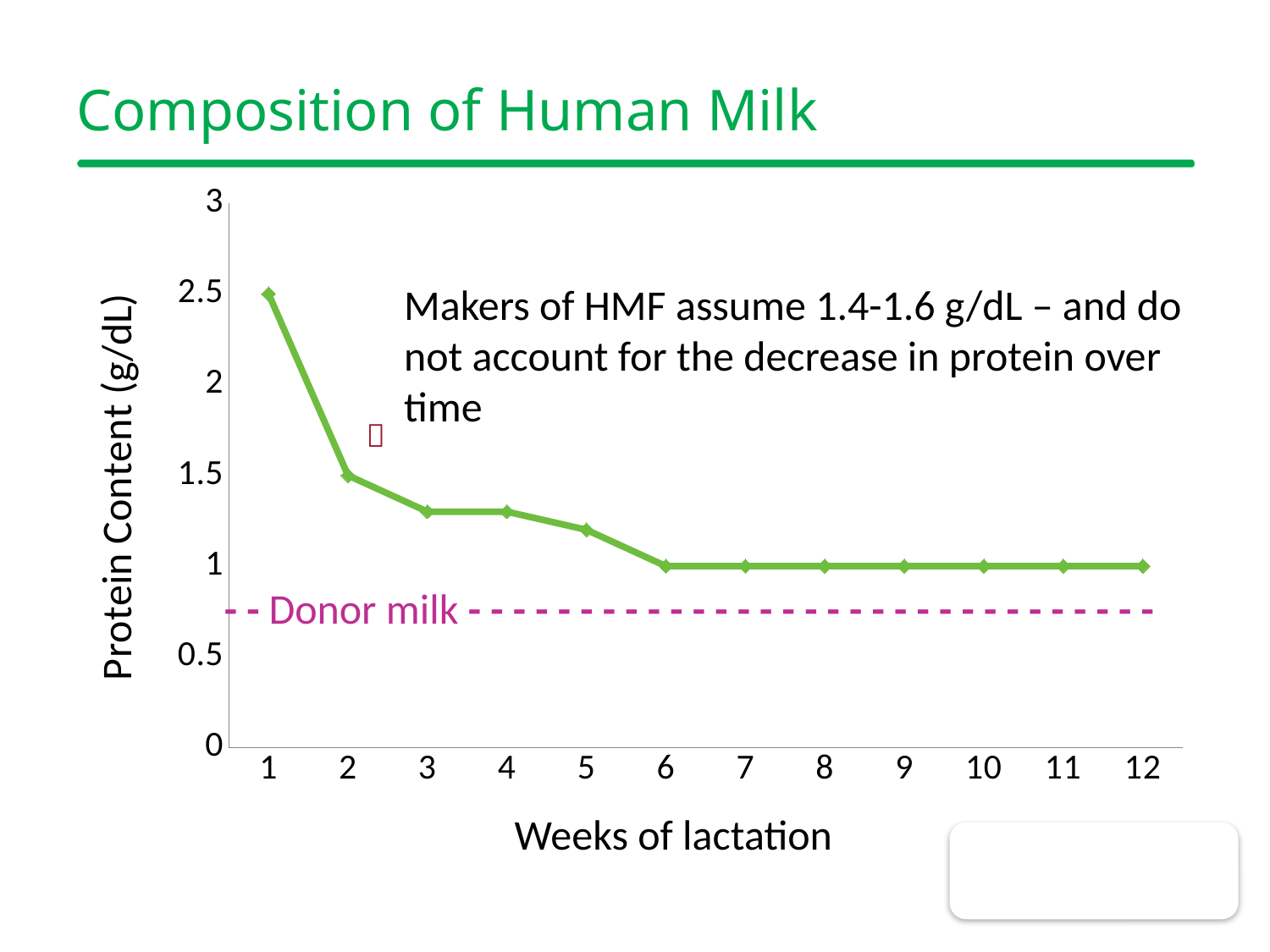
What is the protein content at week 1 of lactation? 2.5 Which week of lactation has the highest protein content? 1 What is the protein content at week 12 of lactation? 1 What kind of chart is shown on the slide? line chart What is the label on the y axis of the chart? Protein Content (g/dL) Is the protein content at week 3 greater or less than 1.5? less What is the protein content at week 2 of lactation? 1.5 How many weeks of lactation are plotted on the x axis? 12 What is the difference in protein content between week 1 and week 2? 1 Which has a higher protein content, week 1 or week 6? week 1 Does the protein content rise or fall as the weeks of lactation increase? fall Is the protein content at week 5 greater or less than 1? greater